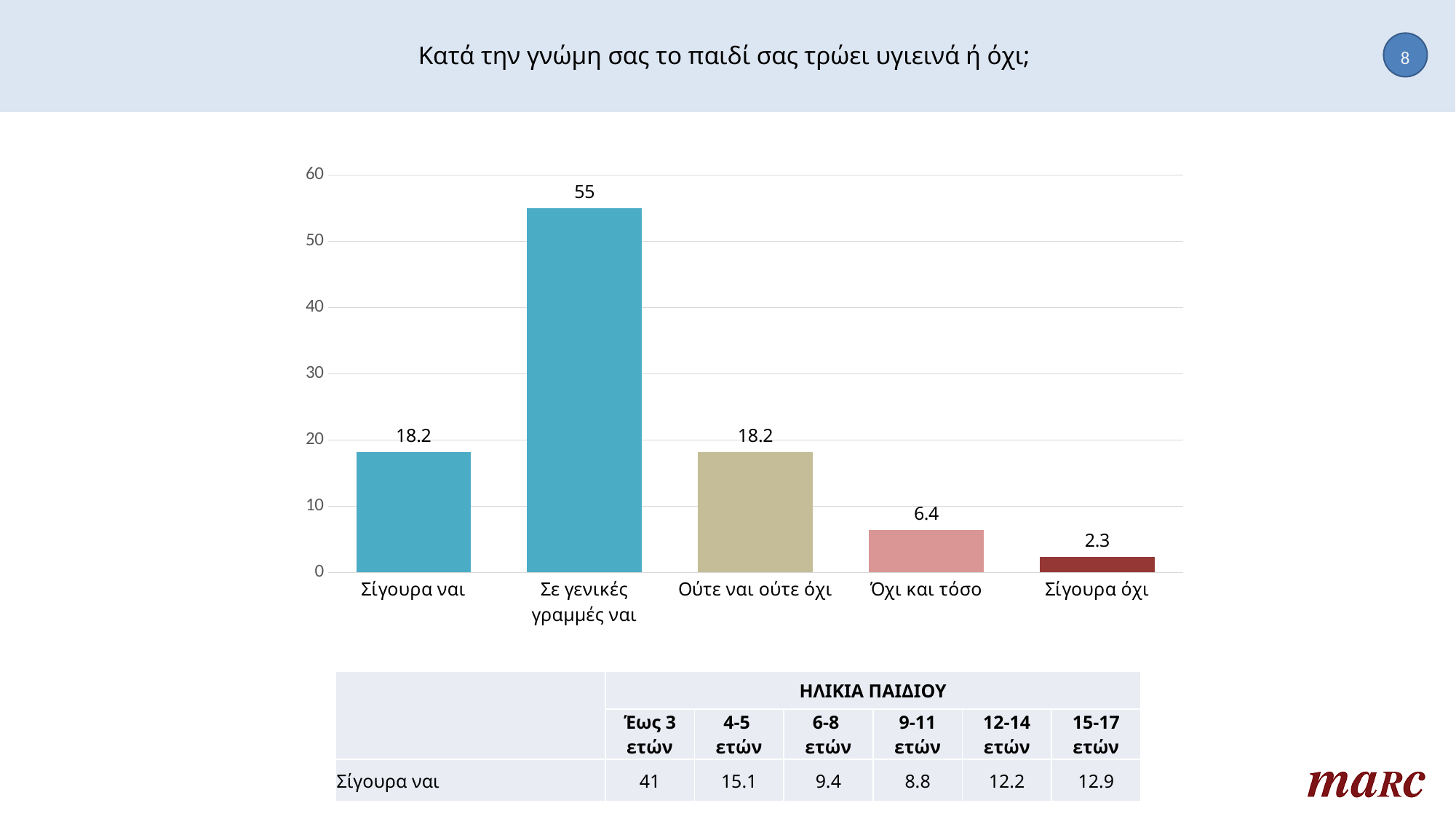
What is the value for "Σε γενικές γραμμές ναι"? 55 What is the difference between the values for "Σε γενικές γραμμές ναι" and "Σίγουρα ναι"? 36.8 Which category has the lowest value? Σίγουρα όχι What is the value for "Σίγουρα ναι"? 18.2 How many categories are shown on the x axis of the chart? 5 What is the value for "Όχι και τόσο"? 6.4 What is the title of the slide above the chart? Κατά την γνώμη σας το παιδί σας τρώει υγιεινά ή όχι; Which category has the highest value? Σε γενικές γραμμές ναι What kind of chart is shown on the slide? Bar chart What is the value for "Σίγουρα όχι"? 2.3 What is the difference between the values for "Όχι και τόσο" and "Σίγουρα όχι"? 4.1 Which is larger, the value for "Ούτε ναι ούτε όχι" or the value for "Όχι και τόσο"? Ούτε ναι ούτε όχι